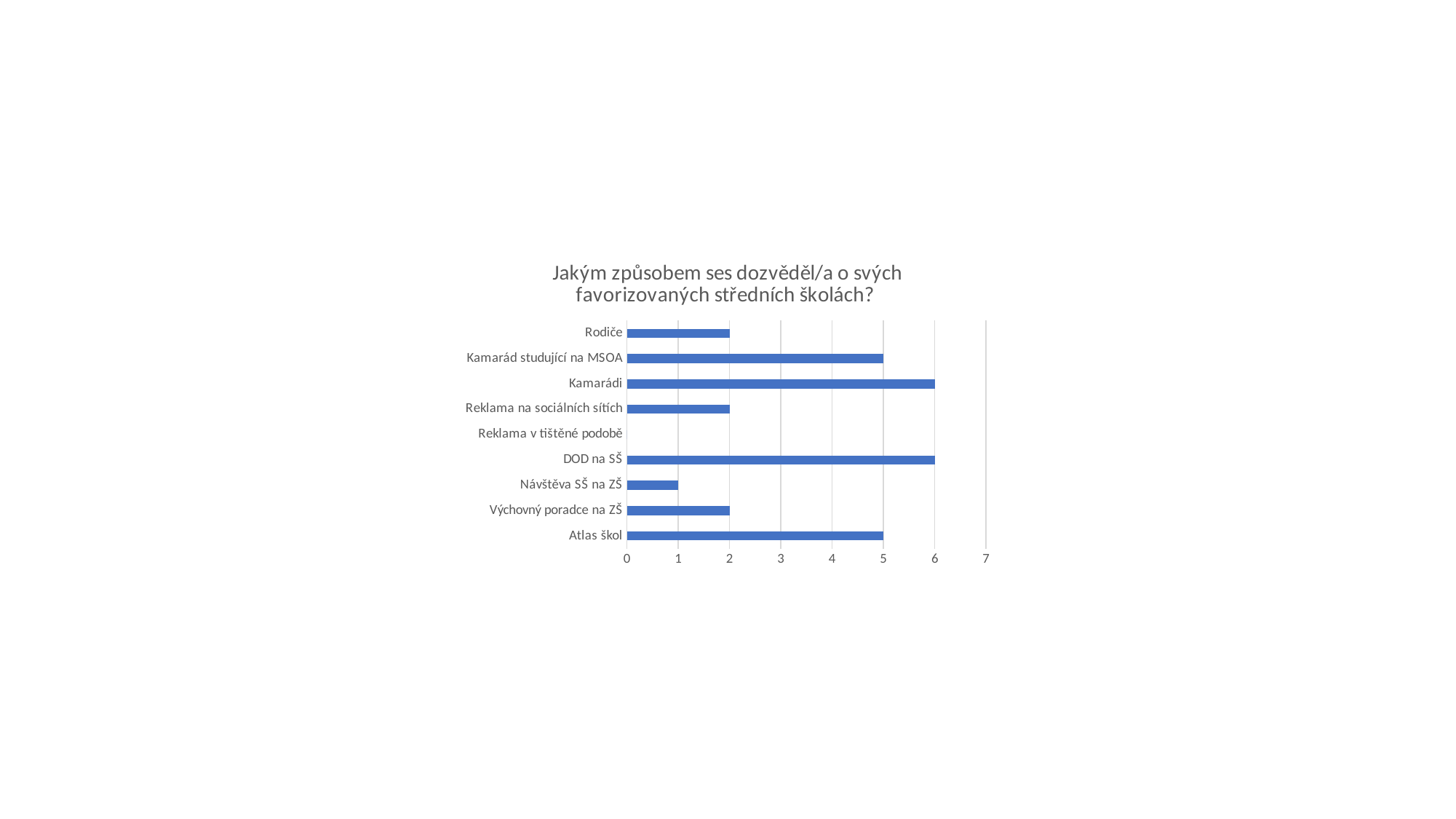
What is the highest value shown on the horizontal axis? 7 Is the value for Atlas škol greater or less than 4? greater What is the value for Atlas škol? 5 What kind of chart is shown on the slide? bar chart Which is larger, the value for Kamarád studující na MSOA or the value for Výchovný poradce na ZŠ? Kamarád studující na MSOA How many categories are shown on the chart? 9 What is the title of the chart? Jakým způsobem ses dozvěděl/a o svých favorizovaných středních školách? Which category has the lowest value? Reklama v tištěné podobě What is the value for Rodiče? 2 What is the value for Návštěva SŠ na ZŠ? 1 What is the value for Kamarádi? 6 What is the difference between the values for DOD na SŠ and Návštěva SŠ na ZŠ? 5